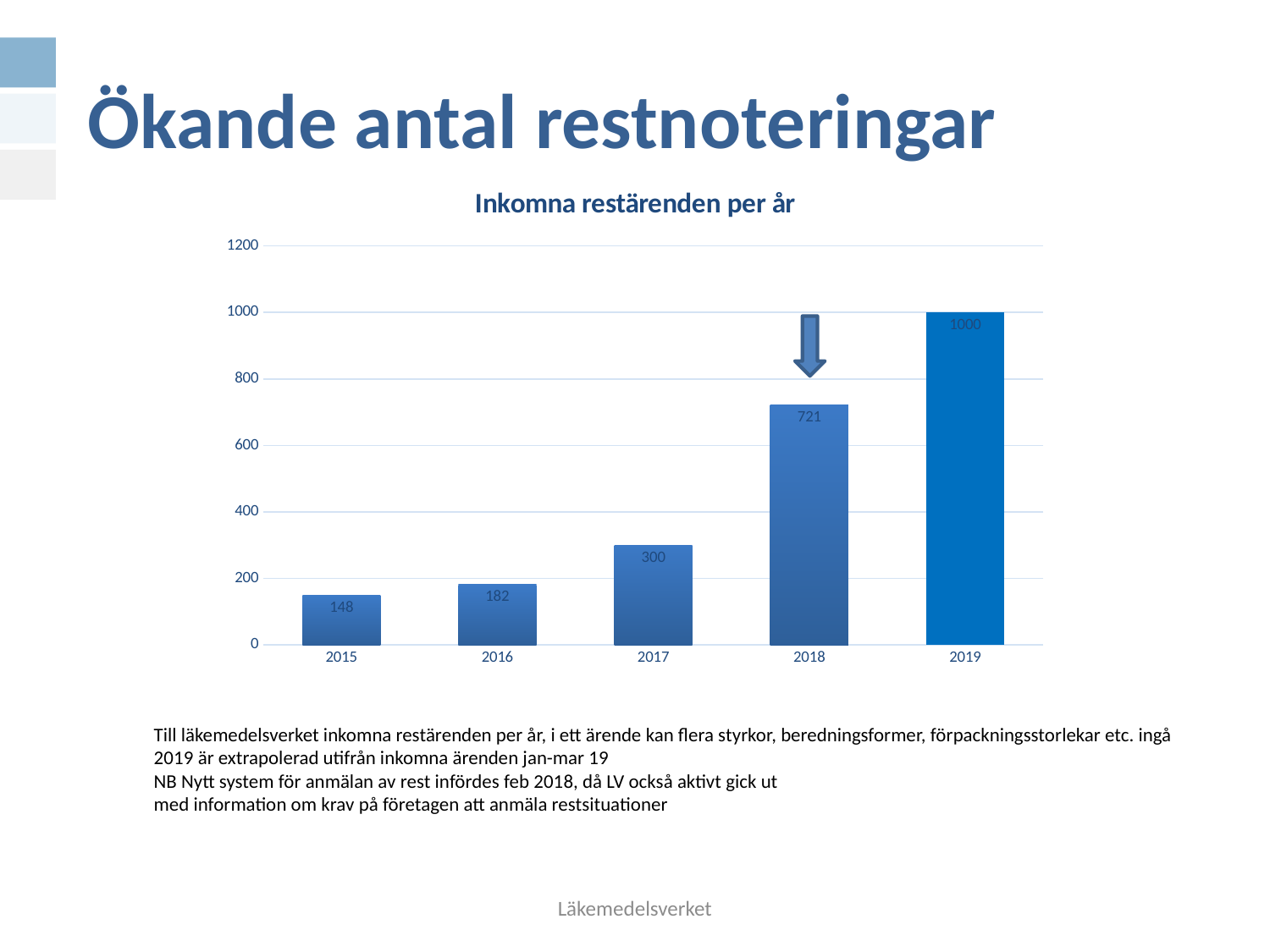
Which is larger, the value for 2016 or the value for 2017? 2017 What is the title of the chart? Inkomna restärenden per år What is the difference between the values for 2016 and 2015? 34 What is the value for 2018 in the chart? 721 How many years are shown on the x axis? 5 What is the value for 2017 in the chart? 300 Which year has the lowest value? 2015 What kind of chart is shown on the slide? Bar chart What is the value for 2015 in the chart? 148 What is the difference between the values for 2018 and 2017? 421 Is the value for 2018 greater or less than 600? greater Which year has the highest value? 2019